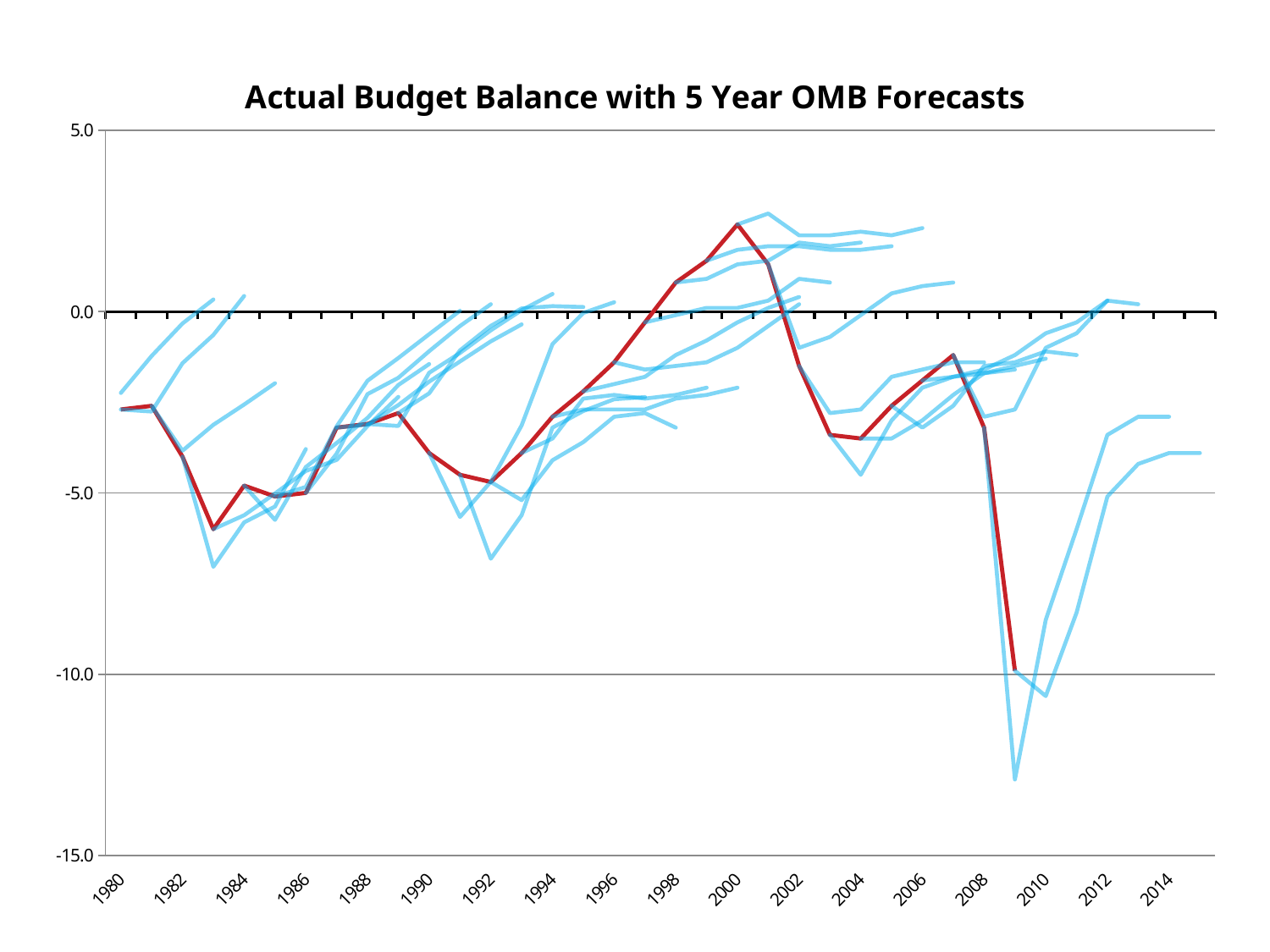
Is the value of the red actual budget balance line in 2007 greater or less than -5.0? greater Does the red actual budget balance line rise or fall between 2007 and 2009? fall What is the title of the chart? Actual Budget Balance with 5 Year OMB Forecasts Is the value of the red actual budget balance line in 1983 greater or less than -5.0? less Is the value of the red actual budget balance line in 2000 greater or less than 0.0? greater In which year does the red actual budget balance line reach its highest value? 2000 Which is larger for the red actual budget balance line: the value in 2000 or the value in 2009? 2000 In which year does the red actual budget balance line reach its lowest value? 2009 What kind of chart is shown on the slide? line chart Does the red actual budget balance line rise or fall between 1992 and 2000? rise How many year labels are shown on the x axis? 18